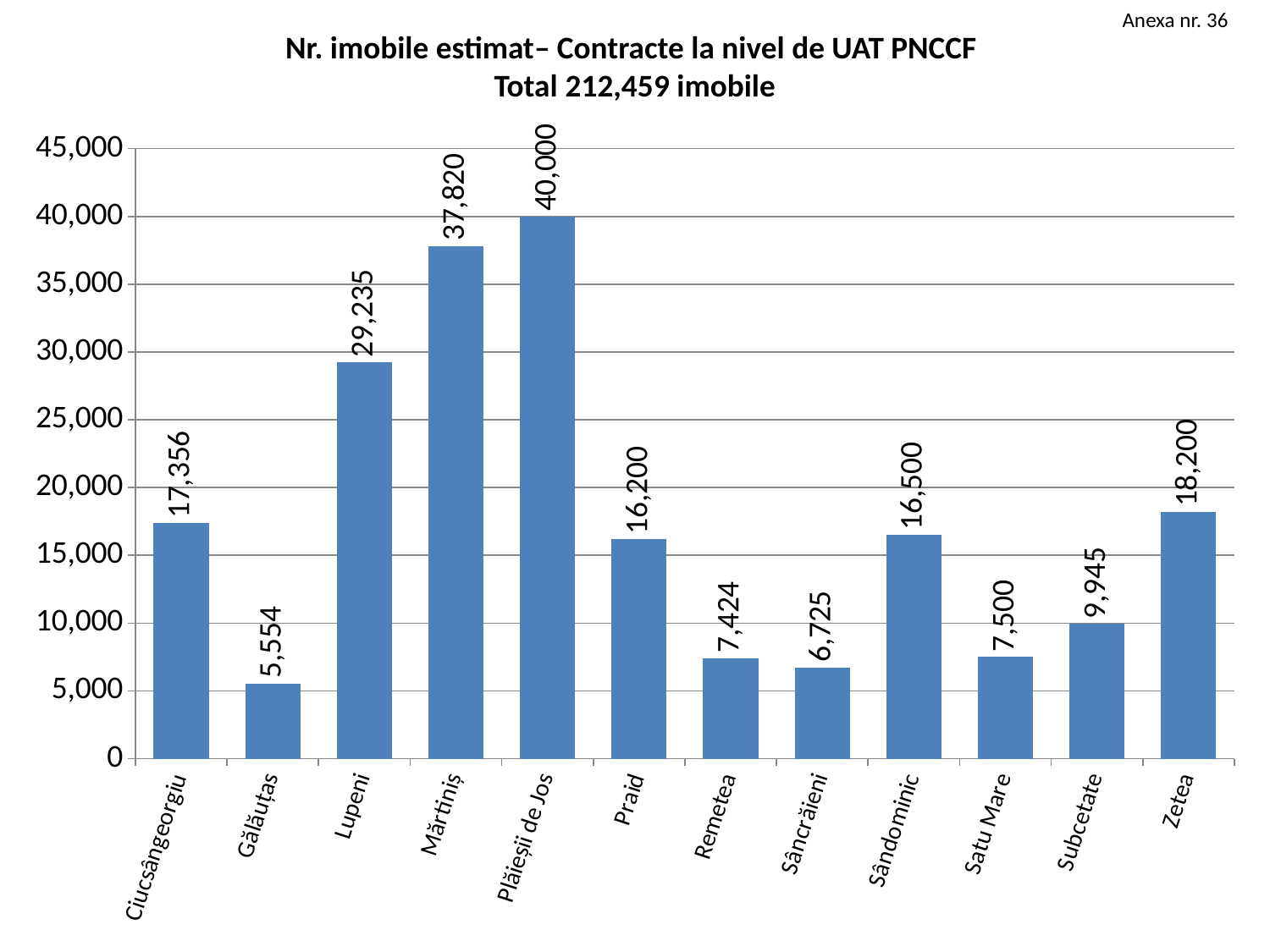
What is the difference between the values for Mărtiniș and Lupeni? 8,585 What is the difference between the values for Satu Mare and Remetea? 76 Is the value for Subcetate greater or less than 10,000? less Which category has the highest value? Plăieșii de Jos What kind of chart is shown on the slide? bar chart What is the value for Plăieșii de Jos? 40,000 Which category has the lowest value? Gălăuțaș How many categories are shown on the x axis? 12 What total number of imobile is stated in the chart title? 212,459 What is the value for Gălăuțaș? 5,554 What is the value for Sândominic? 16,500 Which is larger, the value for Zetea or the value for Ciucsângeorgiu? Zetea